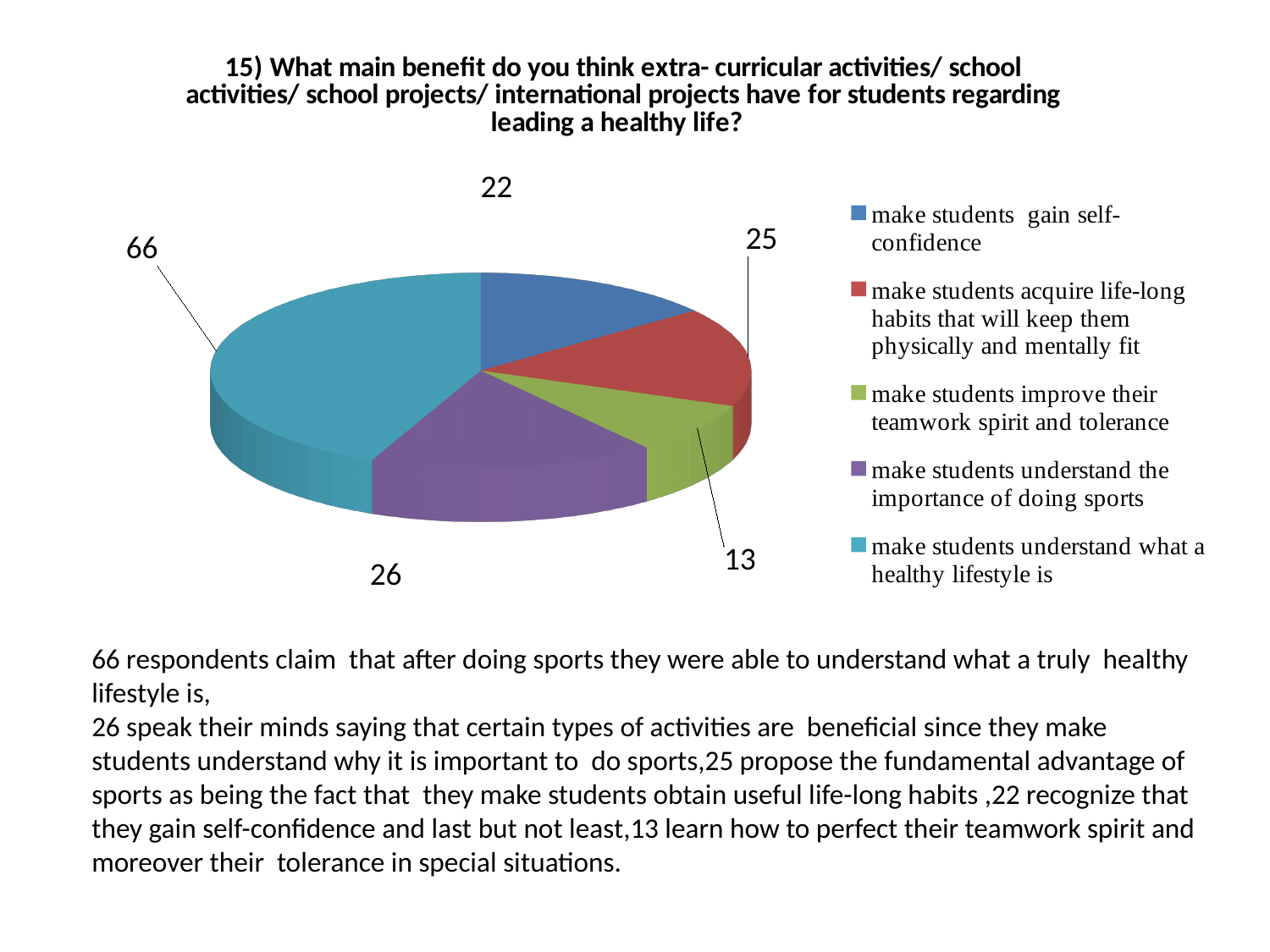
What kind of chart is shown on the slide? pie chart What is the difference between the value for "make students acquire life-long habits that will keep them physically and mentally fit" and the value for "make students gain self-confidence"? 3 What is the total of all the values shown on the pie chart? 152 What value is shown for "make students improve their teamwork spirit and tolerance"? 13 How many slices does the pie chart have? 5 How many entries does the legend list? 5 What is the difference between the value for "make students understand what a healthy lifestyle is" and the value for "make students understand the importance of doing sports"? 40 Which category has the largest slice of the pie? make students understand what a healthy lifestyle is How many respondents chose "make students understand what a healthy lifestyle is"? 66 Which category has the smallest slice of the pie? make students improve their teamwork spirit and tolerance Which is larger: the value for "make students understand the importance of doing sports" or the value for "make students acquire life-long habits that will keep them physically and mentally fit"? make students understand the importance of doing sports What value is shown for "make students gain self-confidence"? 22